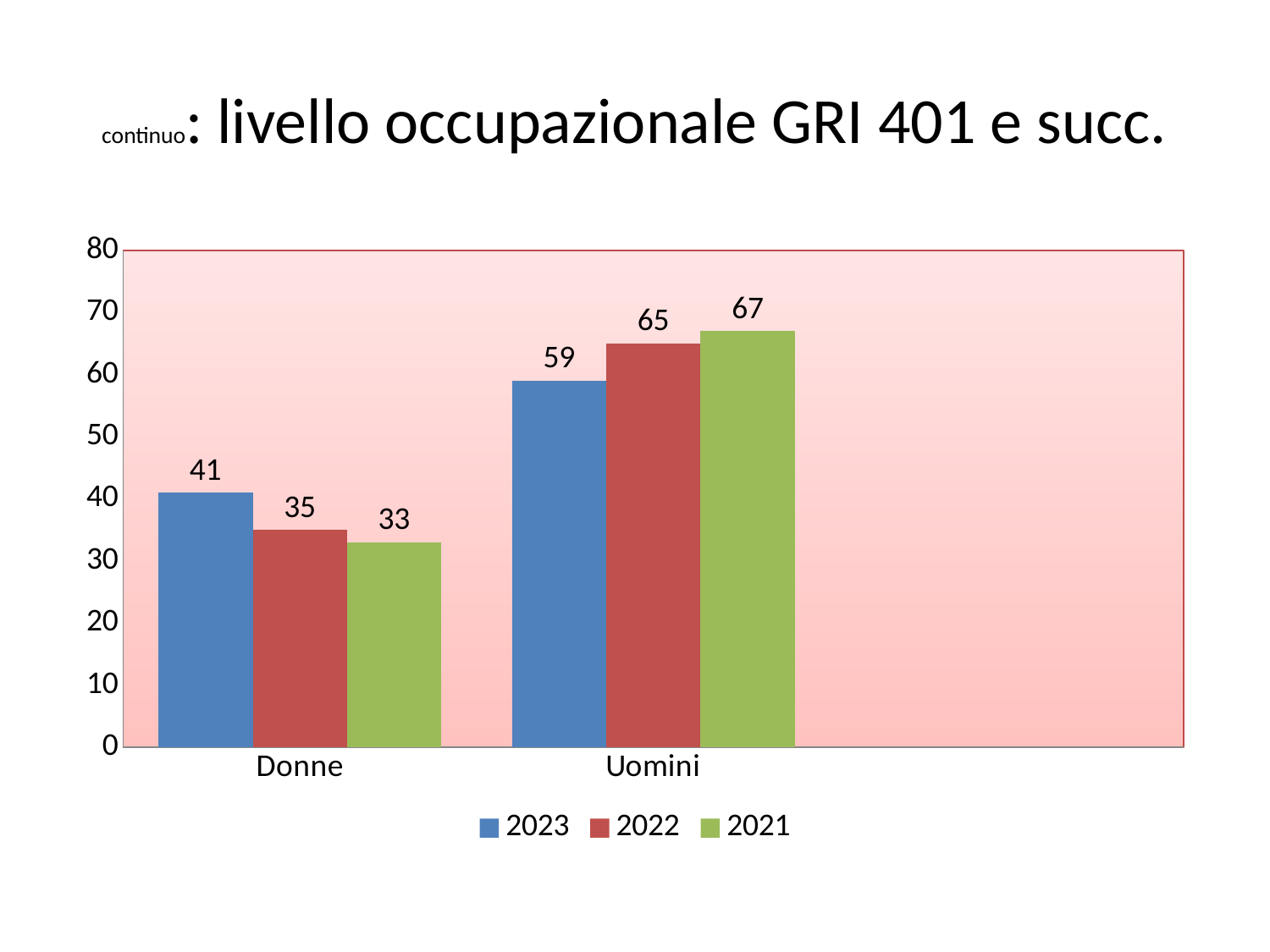
Which colour represents the 2022 series in the legend? red How many series does the legend list? 3 Which is larger, the Donne value in 2023 or the Donne value in 2022? Donne in 2023 Which year has the lowest value for Donne? 2021 How many categories are shown on the x axis? 2 Which year has the highest value for Uomini? 2021 What is the value for Donne in 2022? 35 Is the value for Uomini in 2022 greater or less than 60? greater What kind of chart is shown on the slide? bar chart What is the value for Donne in 2023? 41 What is the value for Uomini in 2021? 67 What is the difference between the Uomini and Donne values in 2023? 18